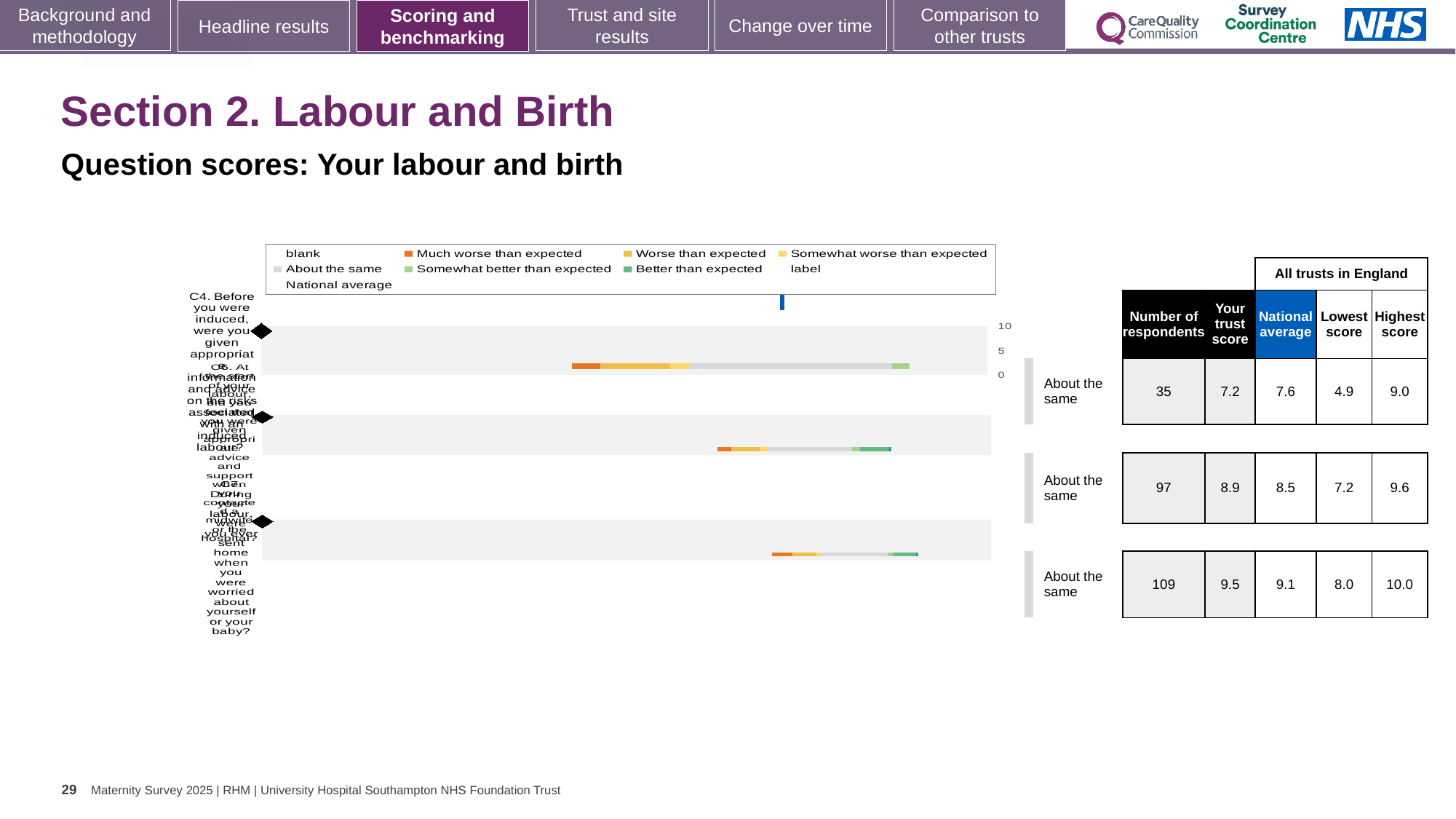
In the chart legend, what colour represents 'Better than expected'? green What benchmark category is shown for all three question rows? About the same Which question row has the lowest trust score? the first (top) row, C4, with 7.2 What is the difference between the highest score and the lowest score for the first question row, C4? 4.1 What kind of chart is shown on the slide? bar chart What is the number of respondents for the first (top) question row, C4? 35 Which question row has the highest number of respondents? the third (bottom) row, with 109 For the second question row, which is larger: the trust score or the national average? trust score In the chart legend, what colour represents 'Much worse than expected'? orange What is the trust score for the third (bottom) question row? 9.5 What is the national average for the second question row? 8.5 How many horizontal bars (question rows) are plotted in the chart? 3